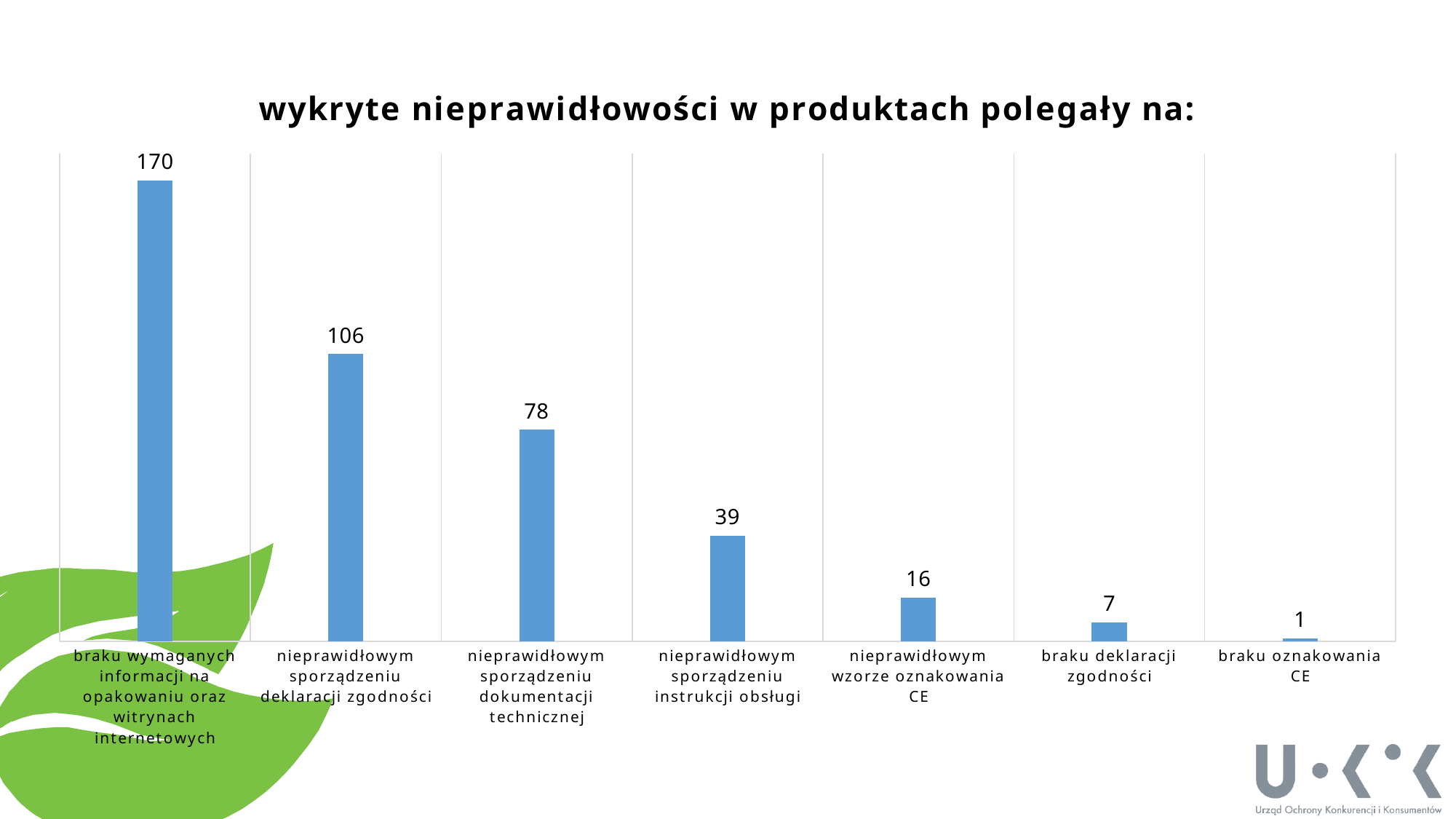
How many categories are shown on the chart? 7 Which category has the lowest value? braku oznakowania CE What is the value for 'nieprawidłowym sporządzeniu deklaracji zgodności'? 106 Which is larger: the value for 'nieprawidłowym sporządzeniu instrukcji obsługi' or 'nieprawidłowym wzorze oznakowania CE'? nieprawidłowym sporządzeniu instrukcji obsługi What is the difference between the values for 'nieprawidłowym sporządzeniu dokumentacji technicznej' and 'nieprawidłowym wzorze oznakowania CE'? 62 Which category has the highest value? braku wymaganych informacji na opakowaniu oraz witrynach internetowych What is the value for 'nieprawidłowym sporządzeniu instrukcji obsługi'? 39 What is the difference between the two highest values on the chart? 64 What is the value for 'braku deklaracji zgodności'? 7 What is the title of the chart? wykryte nieprawidłowości w produktach polegały na: Do the values rise or fall from left to right along the x axis? fall What kind of chart is shown on the slide? bar chart